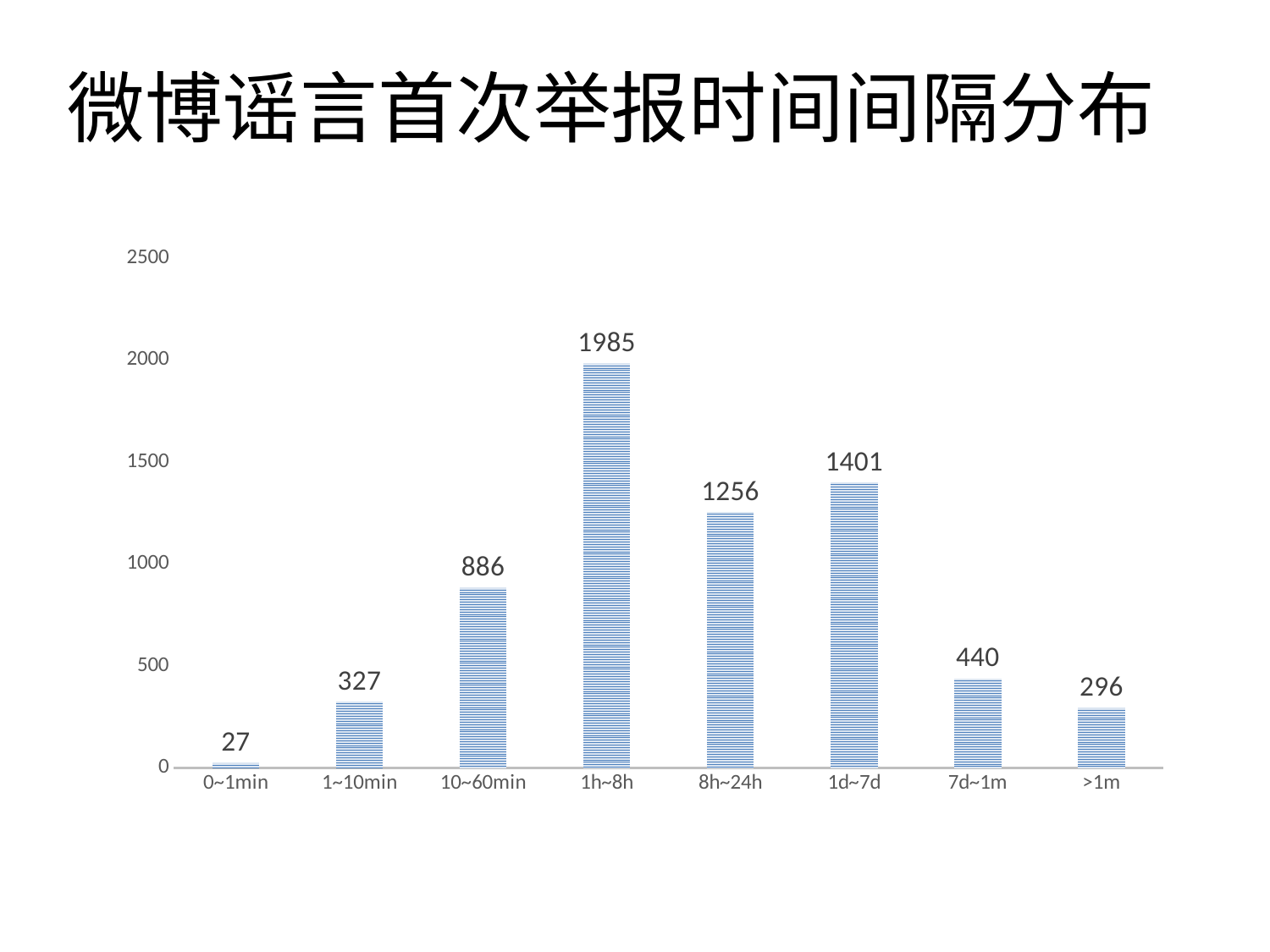
What is the value for the 7d~1m category? 440 Is the value for 10~60min greater or less than 1000? less What is the difference between the values for 1d~7d and 7d~1m? 961 What is the value for the 0~1min category? 27 What is the title of the slide? 微博谣言首次举报时间间隔分布 What is the difference between the values for 1h~8h and 8h~24h? 729 What kind of chart is shown on the slide? bar chart Which is larger, the value for 1d~7d or the value for 8h~24h? 1d~7d Which category has the lowest value? 0~1min What is the value for the 1h~8h category? 1985 How many categories are shown on the x axis? 8 Which category has the highest value? 1h~8h